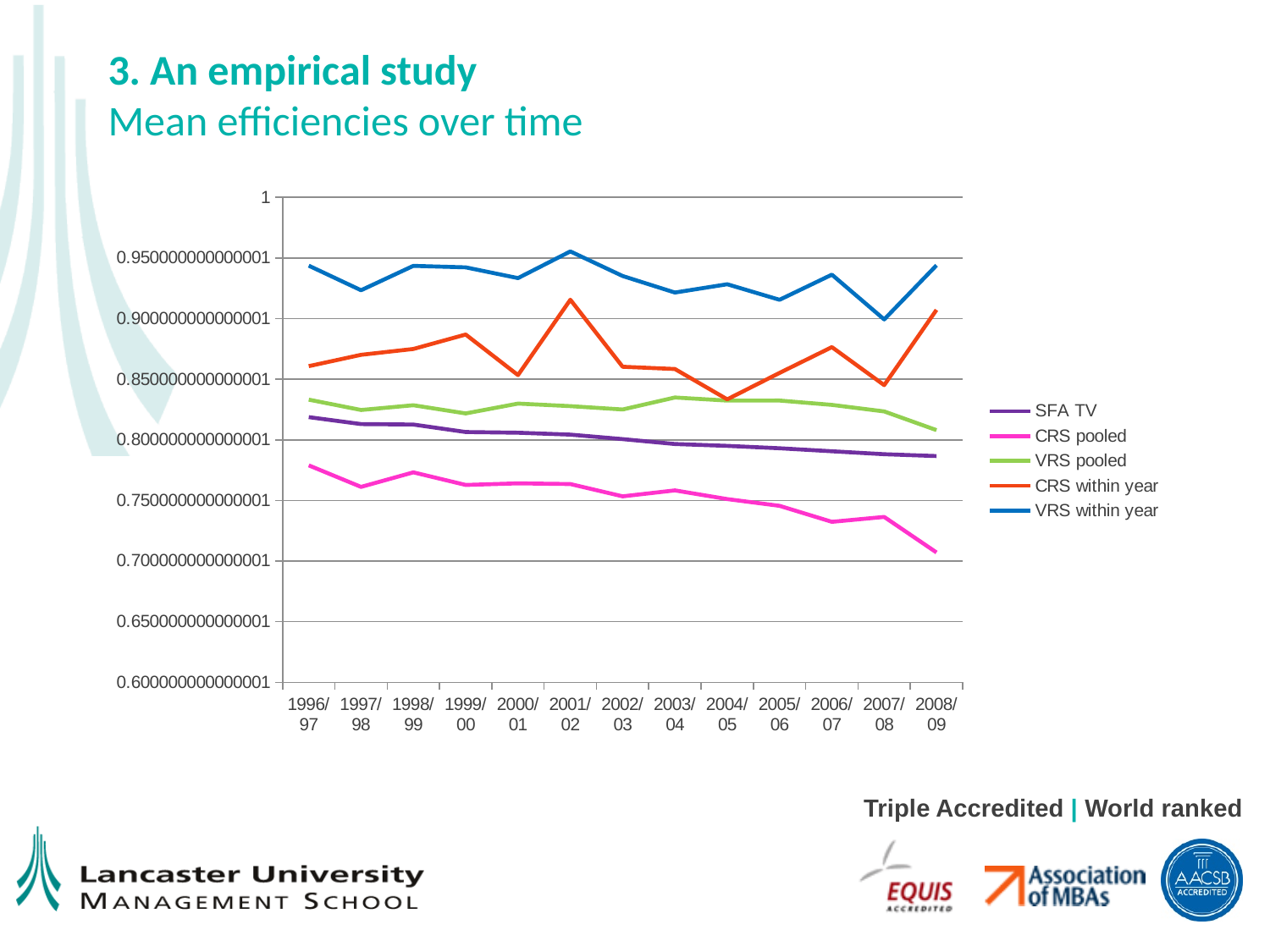
Which series has the lowest value in 2008/09? CRS pooled Is the value for SFA TV in 1996/97 greater or less than 0.8? greater How many series does the legend list? 5 Which series has the highest value in 1996/97? VRS within year Is the value for CRS within year in 2004/05 greater or less than 0.85? less What kind of chart is shown on the slide? line chart In 2008/09, which is higher: VRS within year or CRS within year? VRS within year How many academic years are shown along the x axis? 13 Is the value for VRS within year in 2001/02 greater or less than 0.9? greater Which series are listed in the legend? SFA TV, CRS pooled, VRS pooled, CRS within year, VRS within year What is the subtitle of the chart on the slide? Mean efficiencies over time